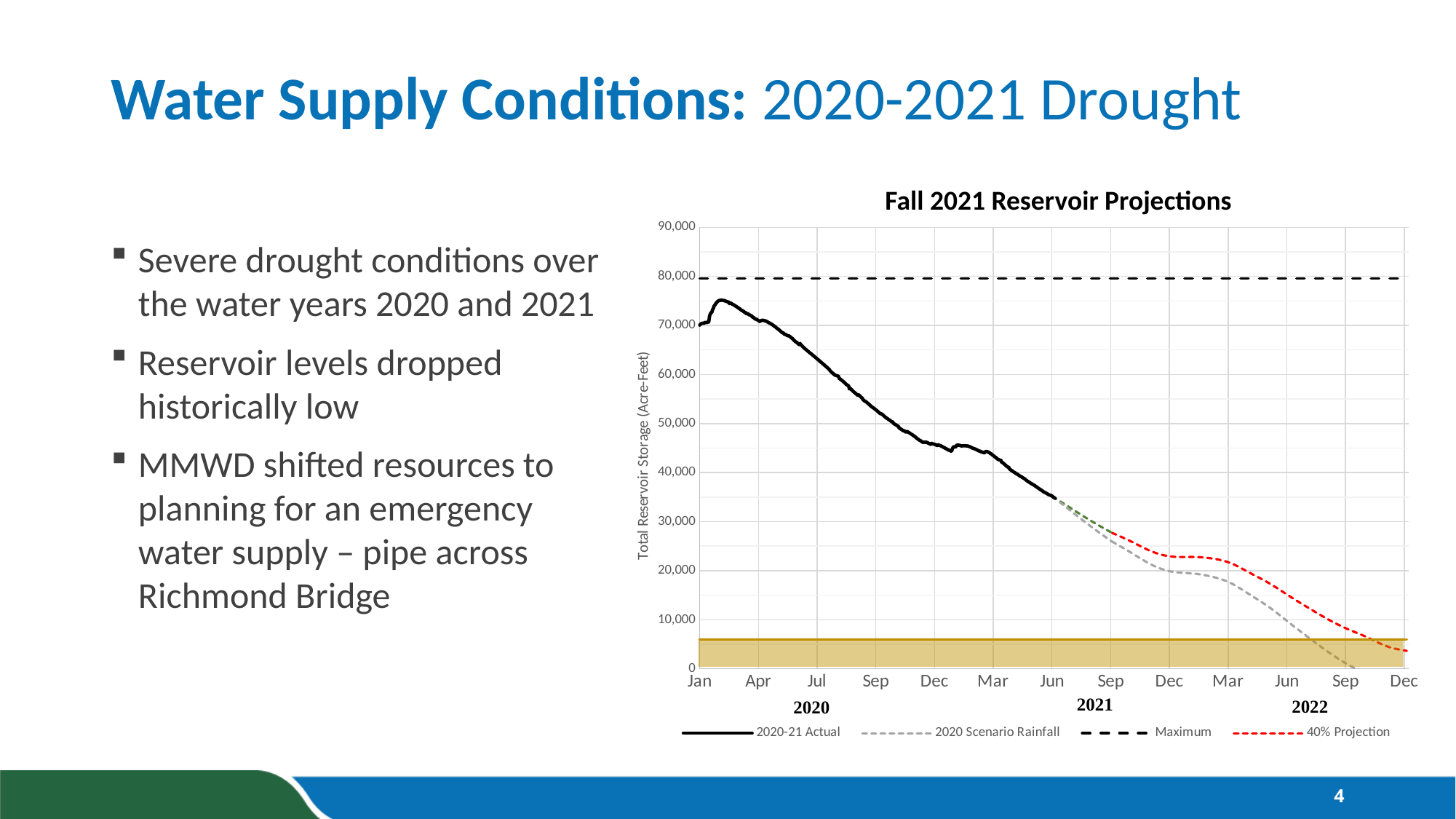
Is the value of the Maximum line greater or less than 70,000? greater How many series does the legend of the Fall 2021 Reservoir Projections chart list? 4 What kind of chart is shown on the slide? line chart What is the title of the chart on the slide? Fall 2021 Reservoir Projections Is the 2020-21 Actual value in Jun 2021 greater or less than 40,000? less Does the 2020-21 Actual line rise or fall from Jan 2020 to Jun 2021? fall Is the 2020-21 Actual value in Dec 2020 greater or less than 50,000? less In Mar 2022, which series is higher: 40% Projection or 2020 Scenario Rainfall? 40% Projection What is the label of the vertical axis of the chart? Total Reservoir Storage (Acre-Feet)